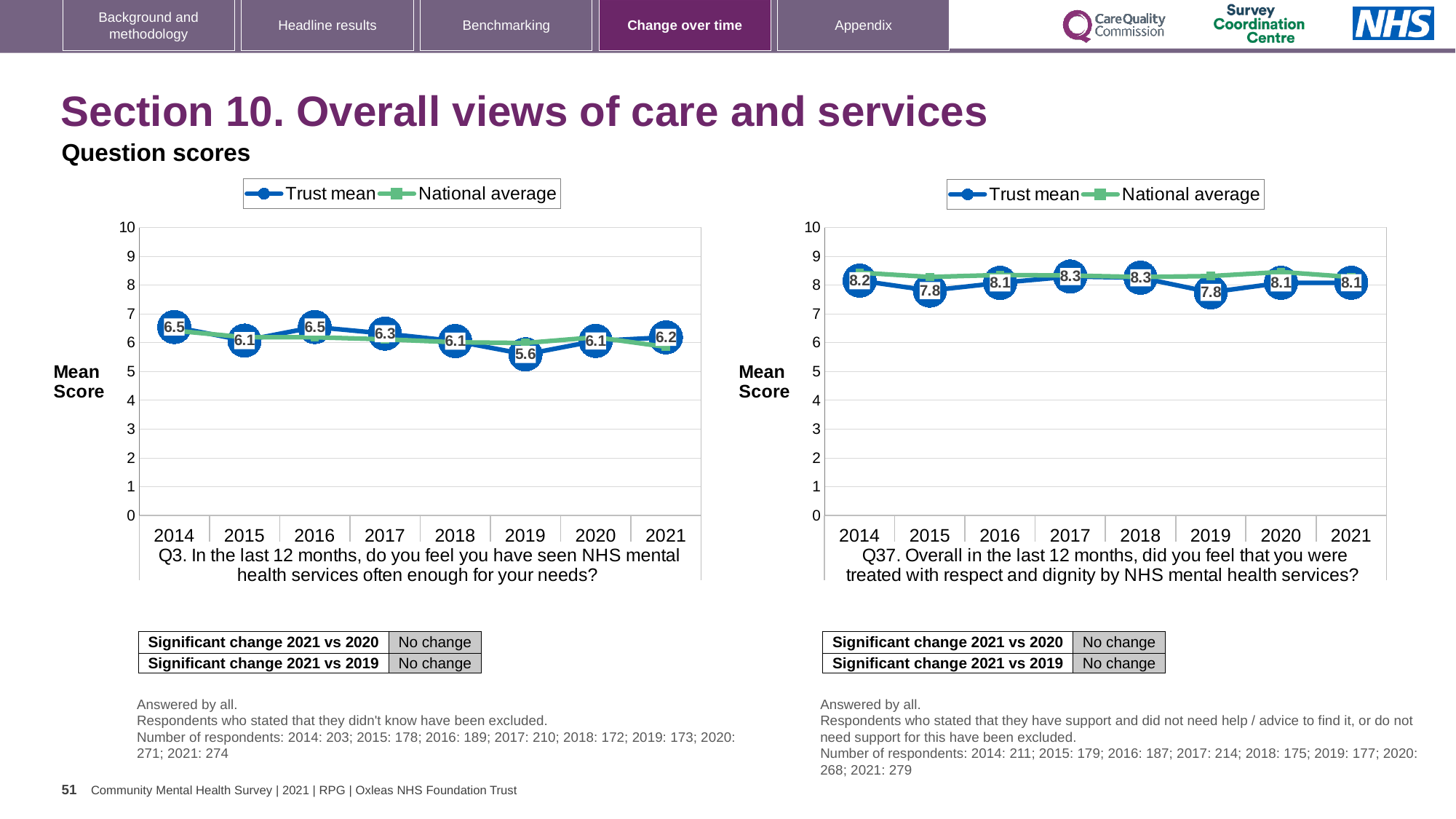
In the Q37 chart on the right, what is the difference between the Trust mean scores for 2017 and 2019? 0.5 How many years are plotted on the x axis of the Q37 chart on the right? 8 In the Q37 chart on the right, what is the Trust mean score for 2015? 7.8 In the Q3 chart on the left, what is the Trust mean score for 2019? 5.6 In the Q3 chart on the left, which year has the lowest Trust mean score? 2019 How many series does the legend of the Q3 chart on the left list? 2 In the Q37 chart on the right, is the Trust mean score for 2014 or 2015 larger? 2014 In the Q3 chart on the left, is the Trust mean value for 2019 greater or less than 6? less What kind of chart is the Q37 chart on the right? Line chart In the Q37 chart on the right, what is the Trust mean score for 2017? 8.3 In the Q3 chart on the left, what is the difference between the Trust mean scores for 2014 and 2019? 0.9 In the Q3 chart on the left, what is the Trust mean score for 2021? 6.2